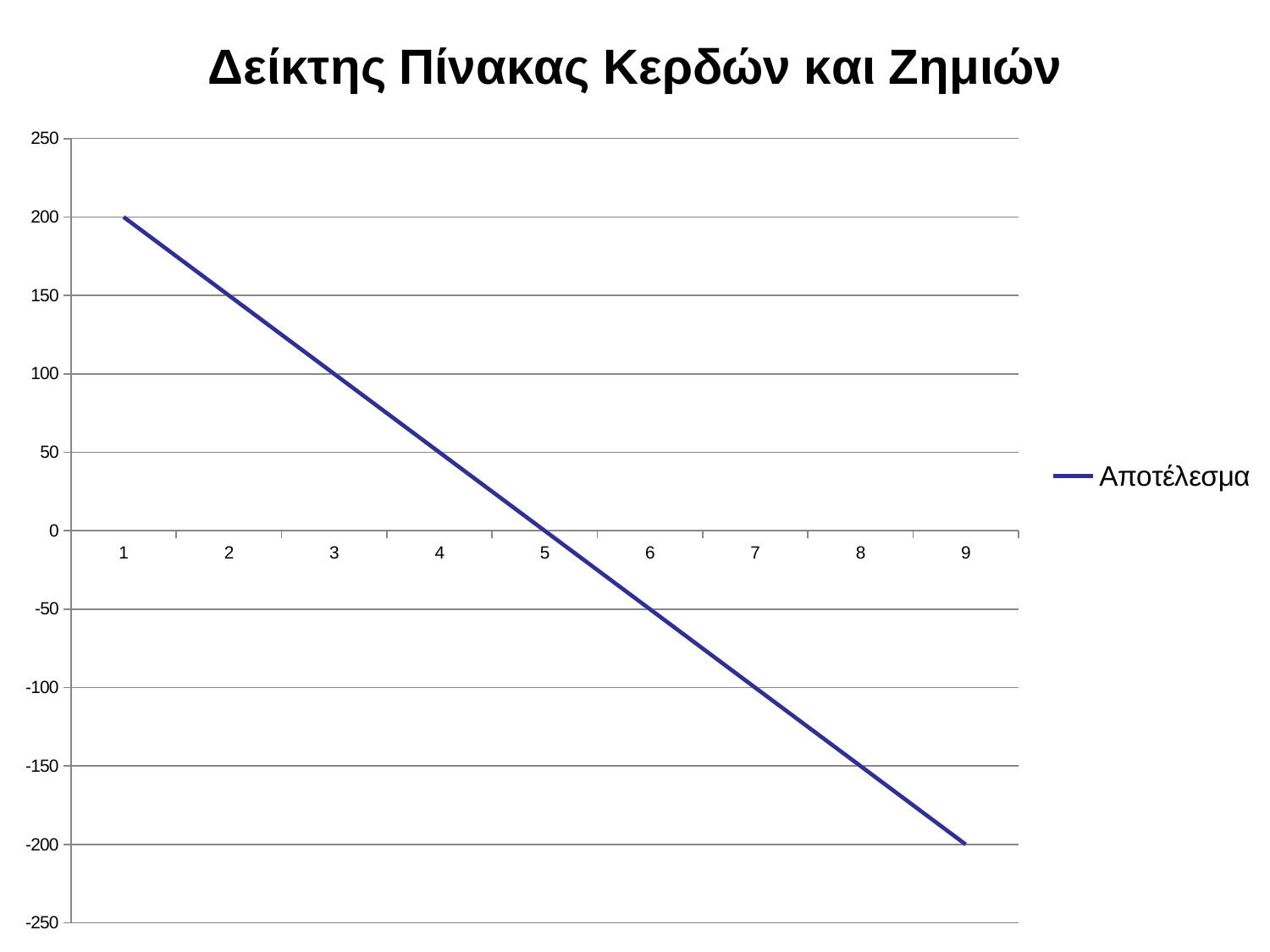
What is the value of Αποτέλεσμα at point 9? -200 At which x-axis point is the value of Αποτέλεσμα lowest? 9 What is the name of the series shown in the legend? Αποτέλεσμα What is the title of the chart? Δείκτης Πίνακας Κερδών και Ζημιών Which is larger, the value of Αποτέλεσμα at point 3 or at point 7? point 3 What is the value of Αποτέλεσμα at point 5? 0 What is the value of Αποτέλεσμα at point 1? 200 At which x-axis point is the value of Αποτέλεσμα highest? 1 How many points are plotted along the x axis? 9 How many series does the legend list? 1 Do the values of Αποτέλεσμα rise or fall from point 1 to point 9? fall What kind of chart is shown on the slide? line chart